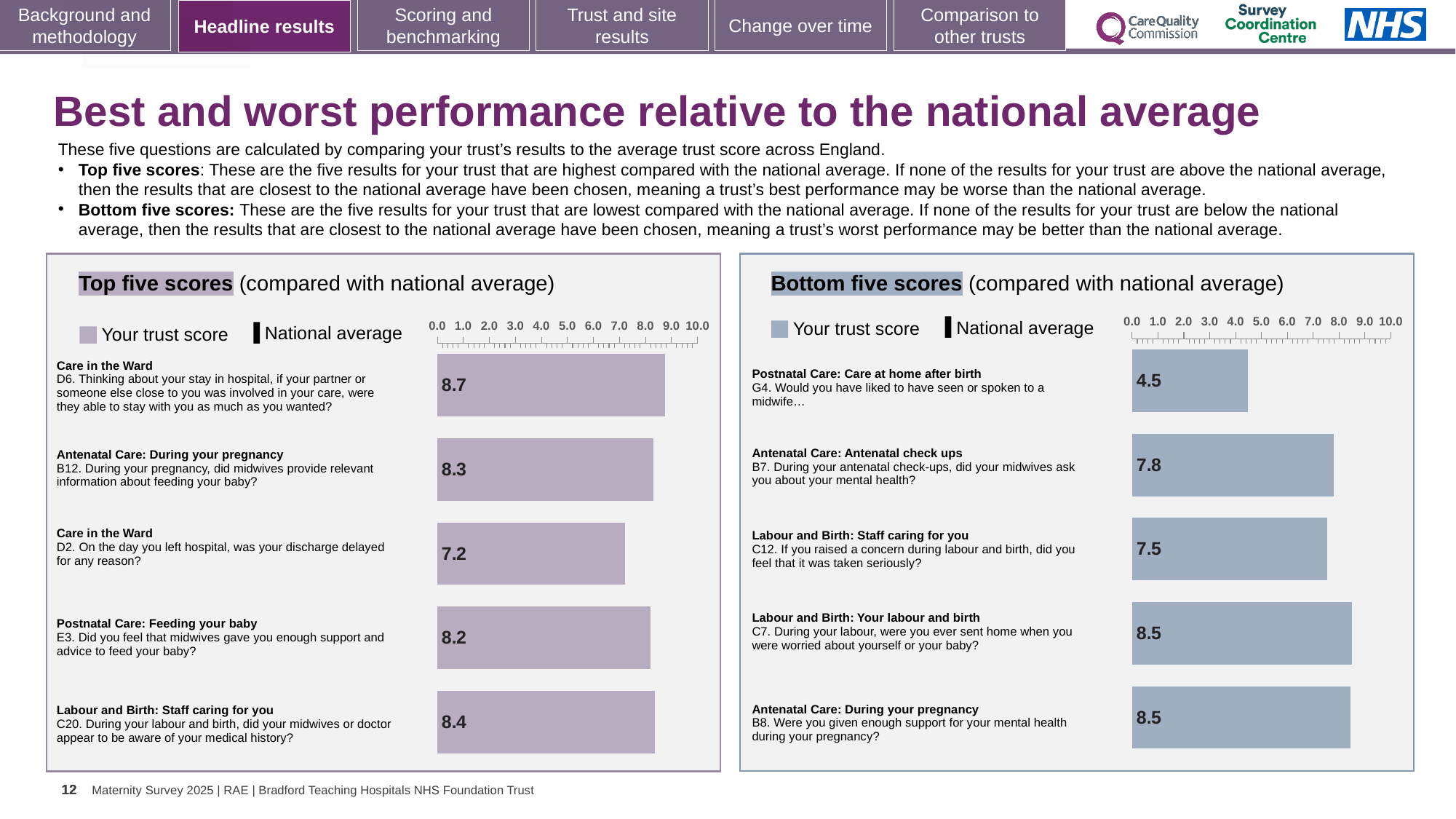
In the Top five scores chart, what is the trust score for D6 (partner or someone close able to stay with you as much as you wanted)? 8.7 In the Top five scores chart, what is the trust score for E3 (enough support and advice to feed your baby)? 8.2 How many questions are shown in the Bottom five scores chart? 5 In the Top five scores chart, which question has the highest trust score? D6 (Care in the Ward) What kind of chart is the Top five scores chart? Bar chart In the Top five scores chart, which has the larger trust score, D6 or B12? D6 In the Bottom five scores chart, what is the difference between the trust scores for B7 and G4? 3.3 In the Bottom five scores chart, what is the trust score for G4 (would you have liked to have seen or spoken to a midwife)? 4.5 In the Bottom five scores chart, which question has the lowest trust score? G4 (Postnatal Care: Care at home after birth) In the Bottom five scores chart, what is the trust score for C12 (concern raised during labour and birth taken seriously)? 7.5 In the Top five scores chart, what is the difference between the trust scores for D6 and D2? 1.5 In the Top five scores chart, which question has the lowest trust score? D2 (Care in the Ward)